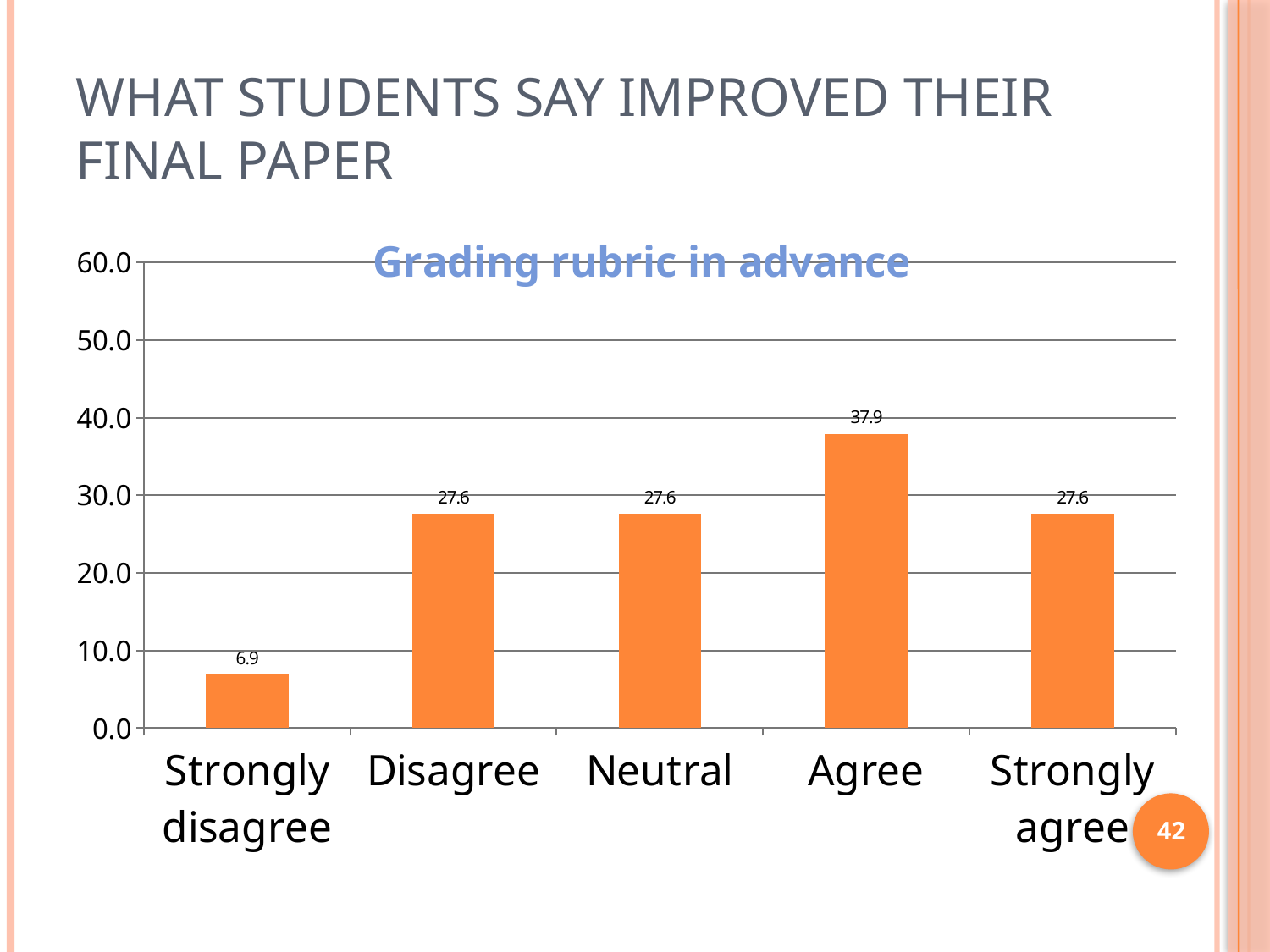
What is the value for Strongly disagree? 6.9 Which is larger, the value for Agree or the value for Strongly agree? Agree What is the value for Neutral? 27.6 Which category has the highest value? Agree Which category has the lowest value? Strongly disagree What is the difference between the values for Strongly agree and Strongly disagree? 20.7 What is the value for Agree? 37.9 What kind of chart is shown on the slide? bar chart How many categories are shown on the x axis? 5 Is the value for Agree greater or less than 30.0? greater What is the title of the chart? Grading rubric in advance What is the difference between the values for Agree and Disagree? 10.3